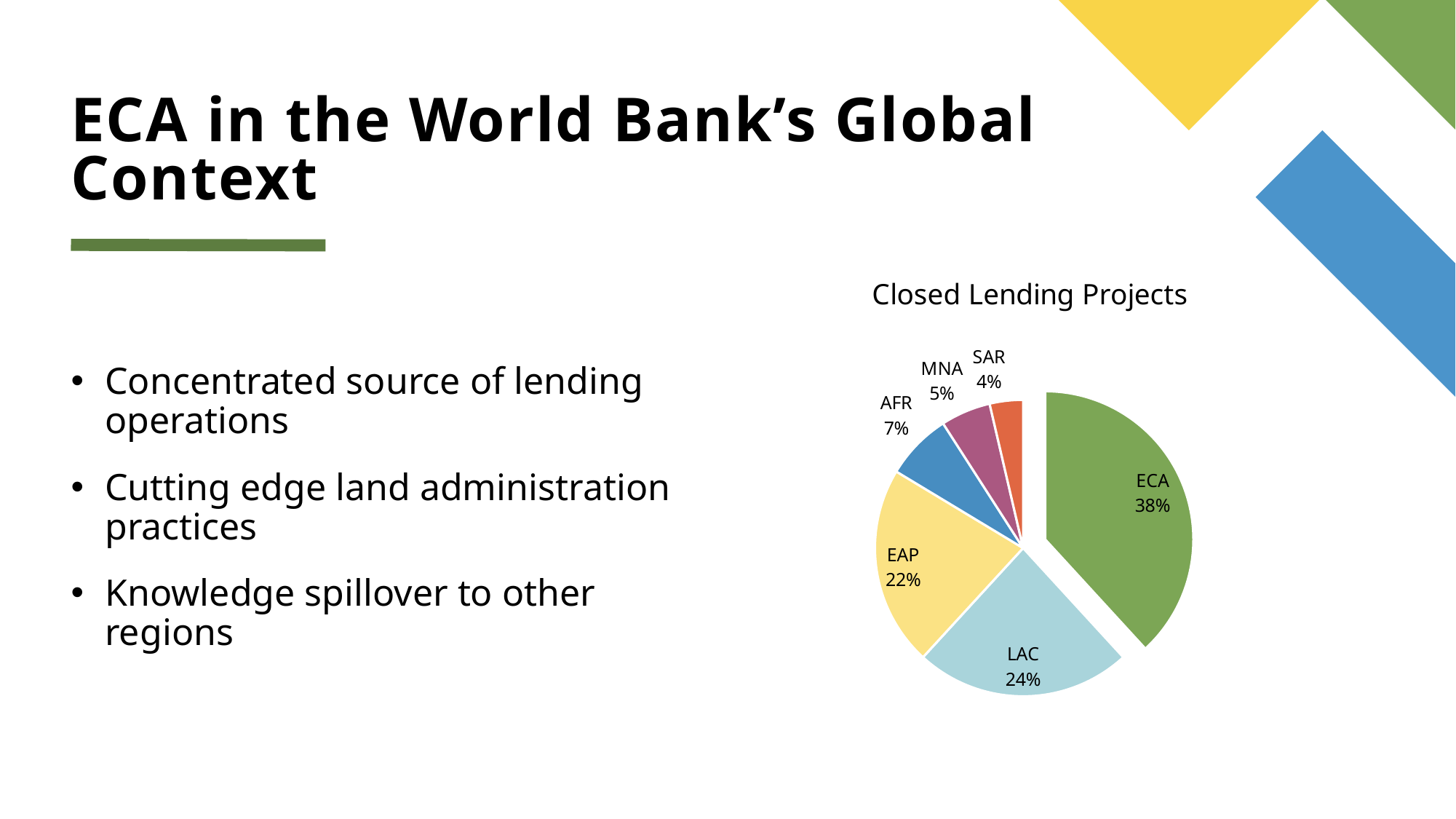
What percentage is shown for LAC? 24% What is the difference in percentage points between ECA and LAC? 14 What percentage is shown for AFR? 7% What share of closed lending projects does ECA account for? 38% What is the title of the chart? Closed Lending Projects Which is larger, the share for MNA or the share for SAR? MNA How many regions are shown in the pie chart? 6 What percentage is shown for EAP? 22% What type of chart is shown on the slide? pie chart Which region has the smallest slice of the pie? SAR Which region has the largest slice of the pie? ECA What colour is the ECA slice? green